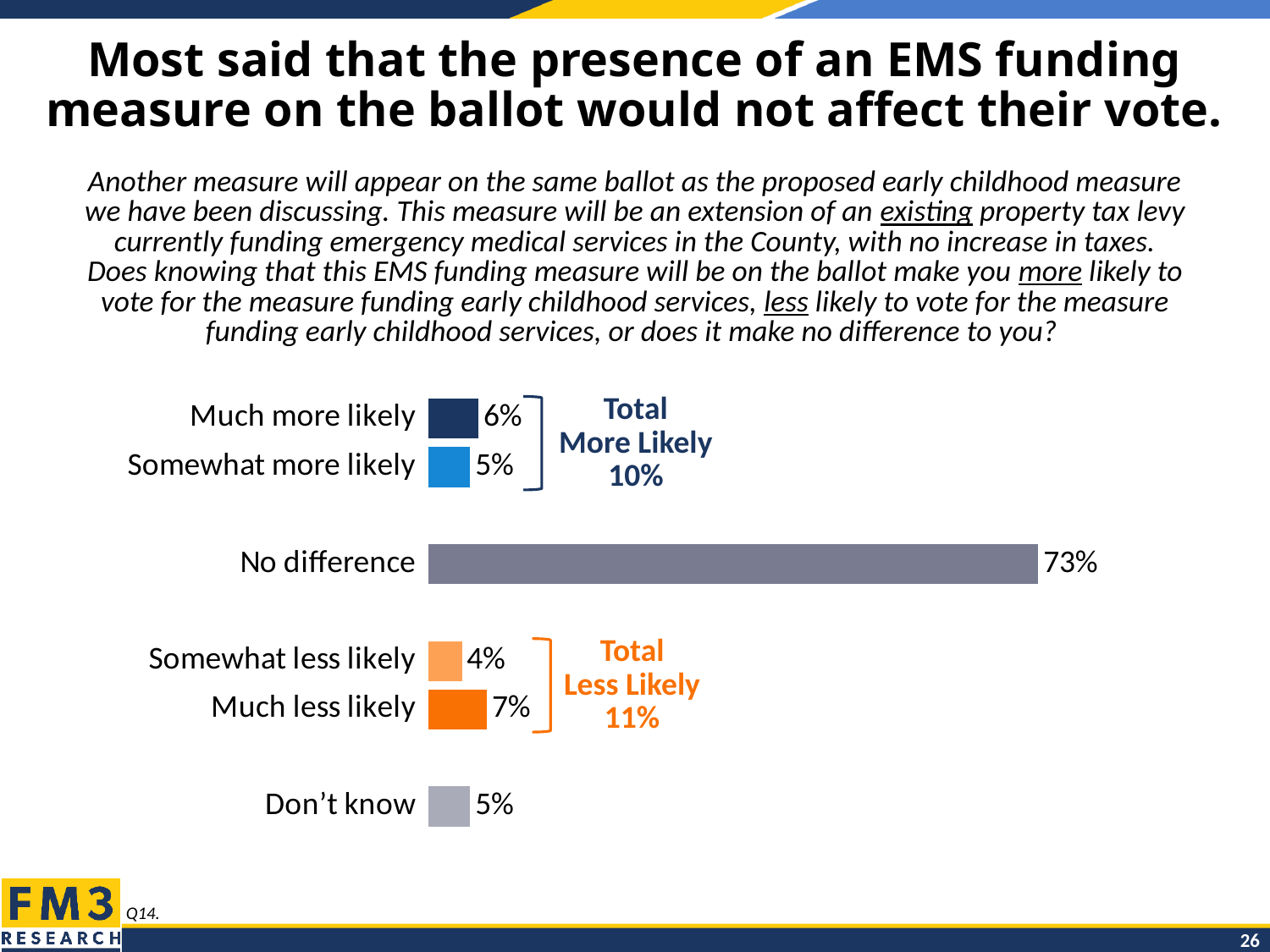
What is the "Total More Likely" percentage shown on the chart? 10% Which is larger, the percentage for "Much more likely" or for "Somewhat more likely"? Much more likely What percentage of respondents said "Much more likely"? 6% What is the "Total Less Likely" percentage shown on the chart? 11% Which response category has the lowest percentage? Somewhat less likely What percentage of respondents said "Don't know"? 5% What percentage of respondents said "No difference"? 73% What is the difference in percentage points between "No difference" and "Much less likely"? 66 What percentage of respondents said "Much less likely"? 7% Which response category has the highest percentage? No difference How many response categories are shown in the chart? 6 What kind of chart is shown on the slide? Bar chart